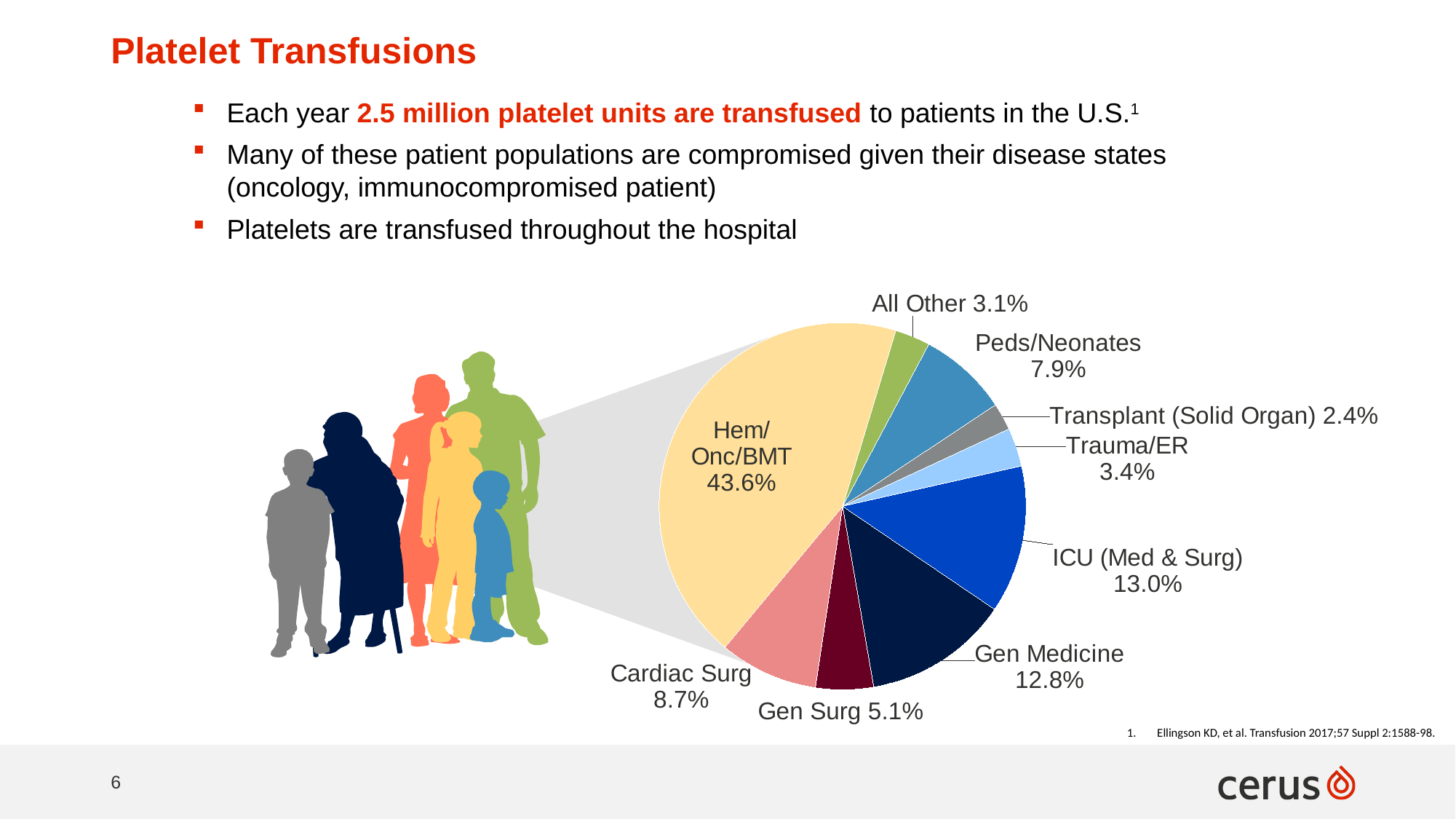
What percentage is shown for ICU (Med & Surg)? 13.0% Which category has the smallest slice of the pie? Transplant (Solid Organ) What percentage is shown for Cardiac Surg? 8.7% How many slices does the pie chart have? 9 What percentage is shown for Transplant (Solid Organ)? 2.4% What is the combined share of Gen Surg and Trauma/ER? 8.5% Which category has the largest slice of the pie? Hem/Onc/BMT What colour is the Hem/Onc/BMT slice? Light yellow What is the difference in percentage points between ICU (Med & Surg) and Gen Medicine? 0.2 What share of platelet transfusions goes to Hem/Onc/BMT? 43.6% Which is larger, Peds/Neonates or Cardiac Surg? Peds/Neonates What kind of chart is shown on the slide? Pie chart